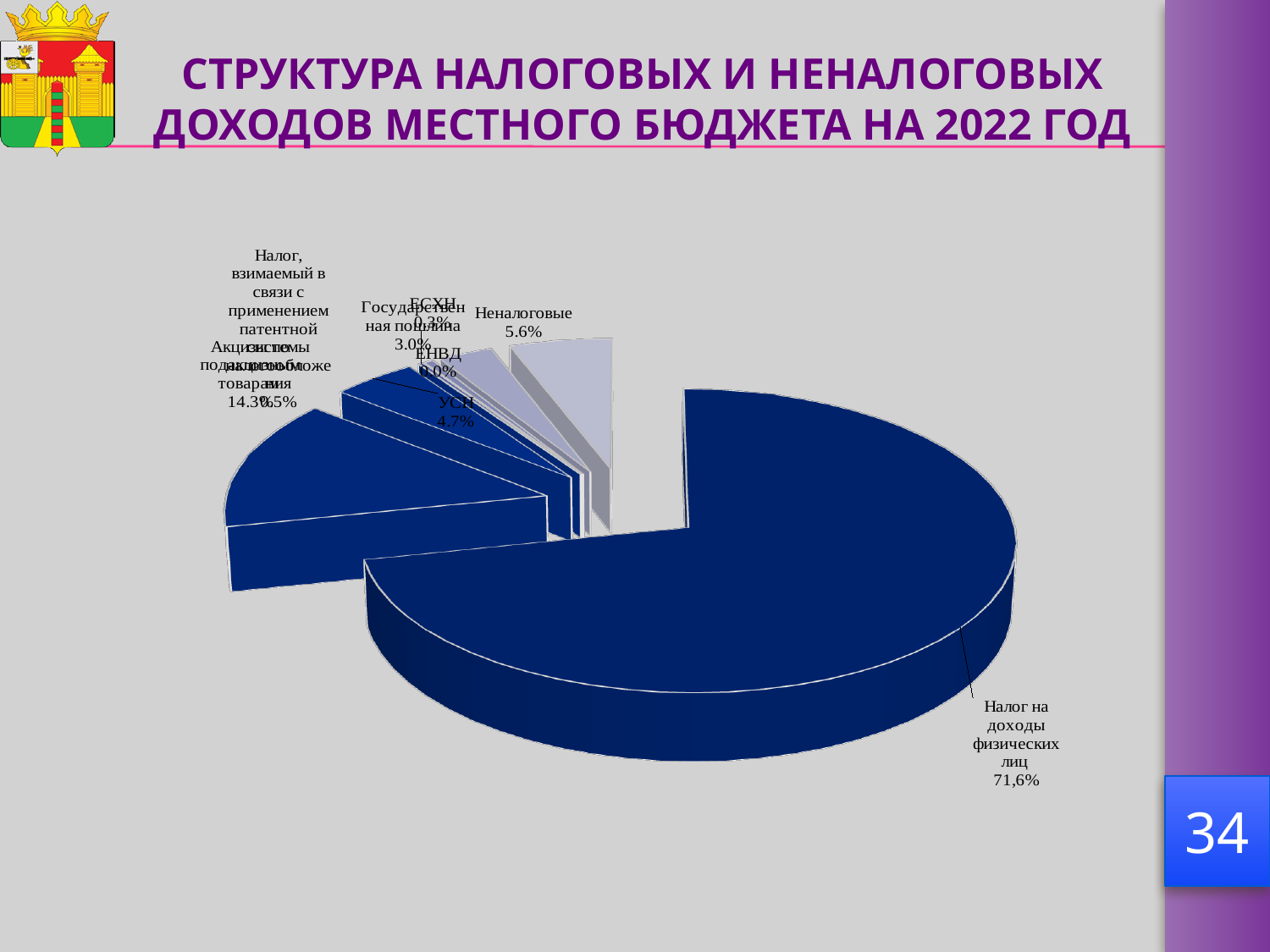
What share is shown for "ЕСХН"? 0.3% What share is shown for "Неналоговые"? 5.6% What share is shown for "ЕНВД"? 0.0% What share is shown for "Акцизы по подакцизным товарам"? 14.3% What share is shown for "Государственная пошлина"? 3.0% By how many percentage points does "Налог на доходы физических лиц" exceed "Неналоговые"? 66,0 What kind of chart is shown on the slide? pie chart What is the title of the slide containing the chart? СТРУКТУРА НАЛОГОВЫХ И НЕНАЛОГОВЫХ ДОХОДОВ МЕСТНОГО БЮДЖЕТА НА 2022 ГОД Which category has the largest slice of the pie? Налог на доходы физических лиц What share of the pie is labelled "Налог на доходы физических лиц"? 71,6% Which is larger, the share for "Неналоговые" or the share for "УСН"? Неналоговые What share is shown for "УСН"? 4.7%